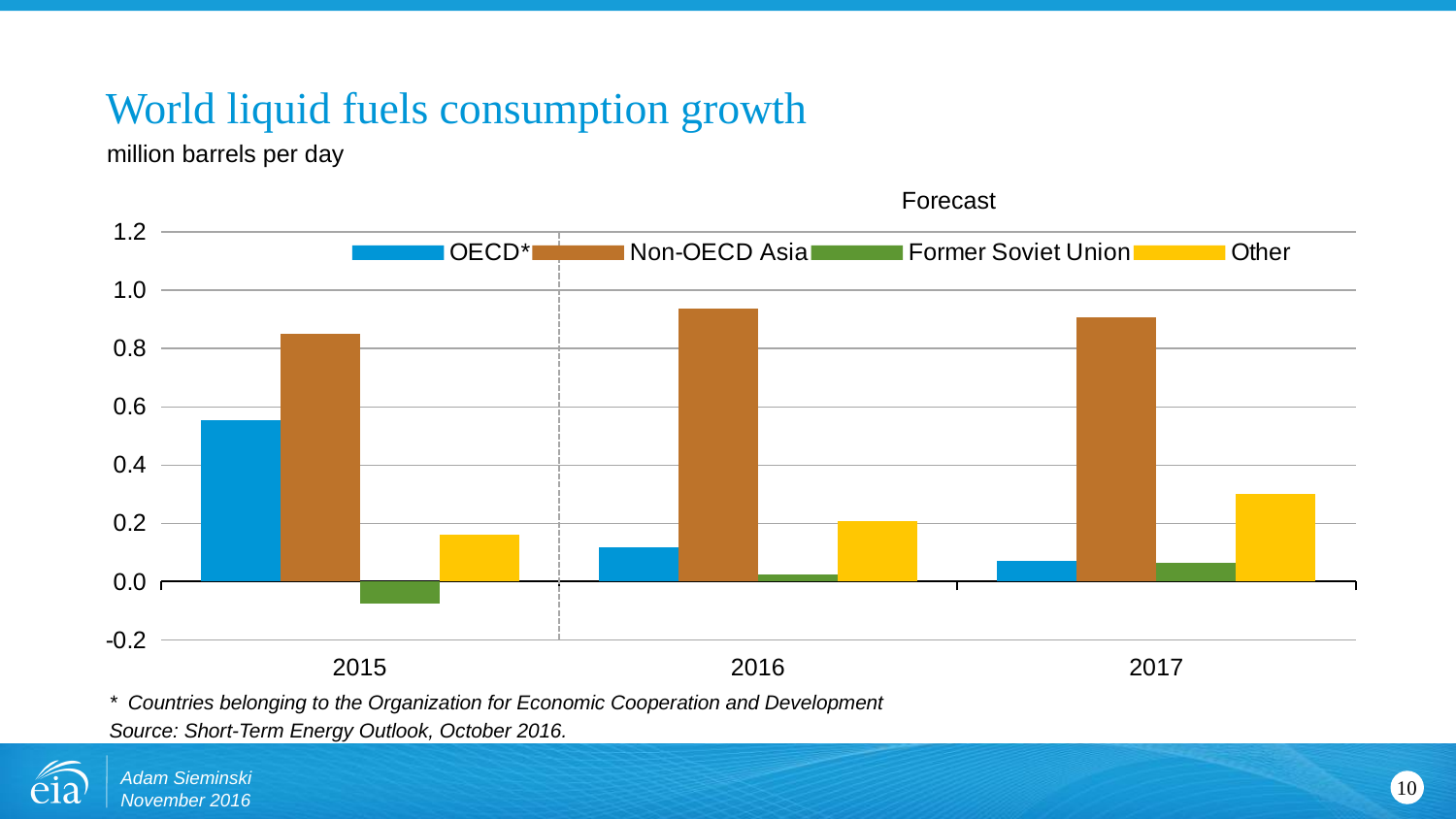
What kind of chart is shown on the slide? bar chart Which is larger, the OECD* value in 2015 or the OECD* value in 2017? 2015 What unit is the chart measured in, according to the subtitle? million barrels per day Which series has the lowest value in 2015? Former Soviet Union Is the value for Former Soviet Union in 2015 greater or less than 0.0? less Is the value for OECD* in 2016 greater or less than 0.2? less How many series does the legend list? 4 Does the OECD* value rise or fall from 2015 to 2017? fall Which series has the highest value in 2015? Non-OECD Asia Is the value for Non-OECD Asia in 2016 greater or less than 0.8? greater How many years are shown on the x axis? 3